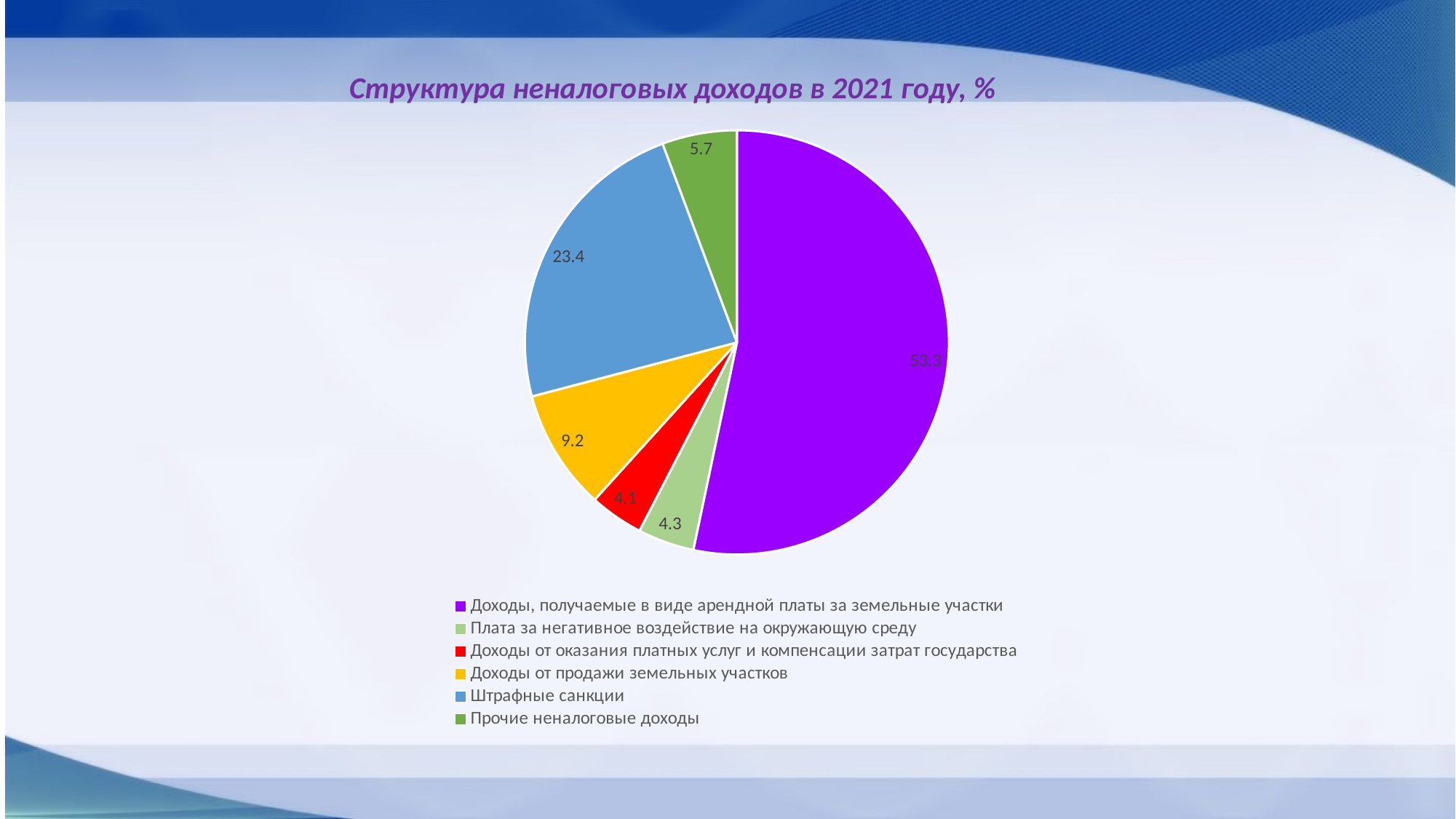
What is the value for Штрафные санкции? 23.4 What is the value for Прочие неналоговые доходы? 5.7 How many slices does the pie chart have? 6 What colour is the slice for Штрафные санкции? blue What type of chart is shown on the slide? pie chart Which category has the largest share of the pie? Доходы, получаемые в виде арендной платы за земельные участки Which category has the smallest share of the pie? Доходы от оказания платных услуг и компенсации затрат государства Which is larger: the value for Прочие неналоговые доходы or the value for Плата за негативное воздействие на окружающую среду? Прочие неналоговые доходы What is the value for Доходы от продажи земельных участков? 9.2 What is the difference between the values for Штрафные санкции and Доходы от продажи земельных участков? 14.2 What is the title of the chart? Структура неналоговых доходов в 2021 году, % What is the value for Плата за негативное воздействие на окружающую среду? 4.3